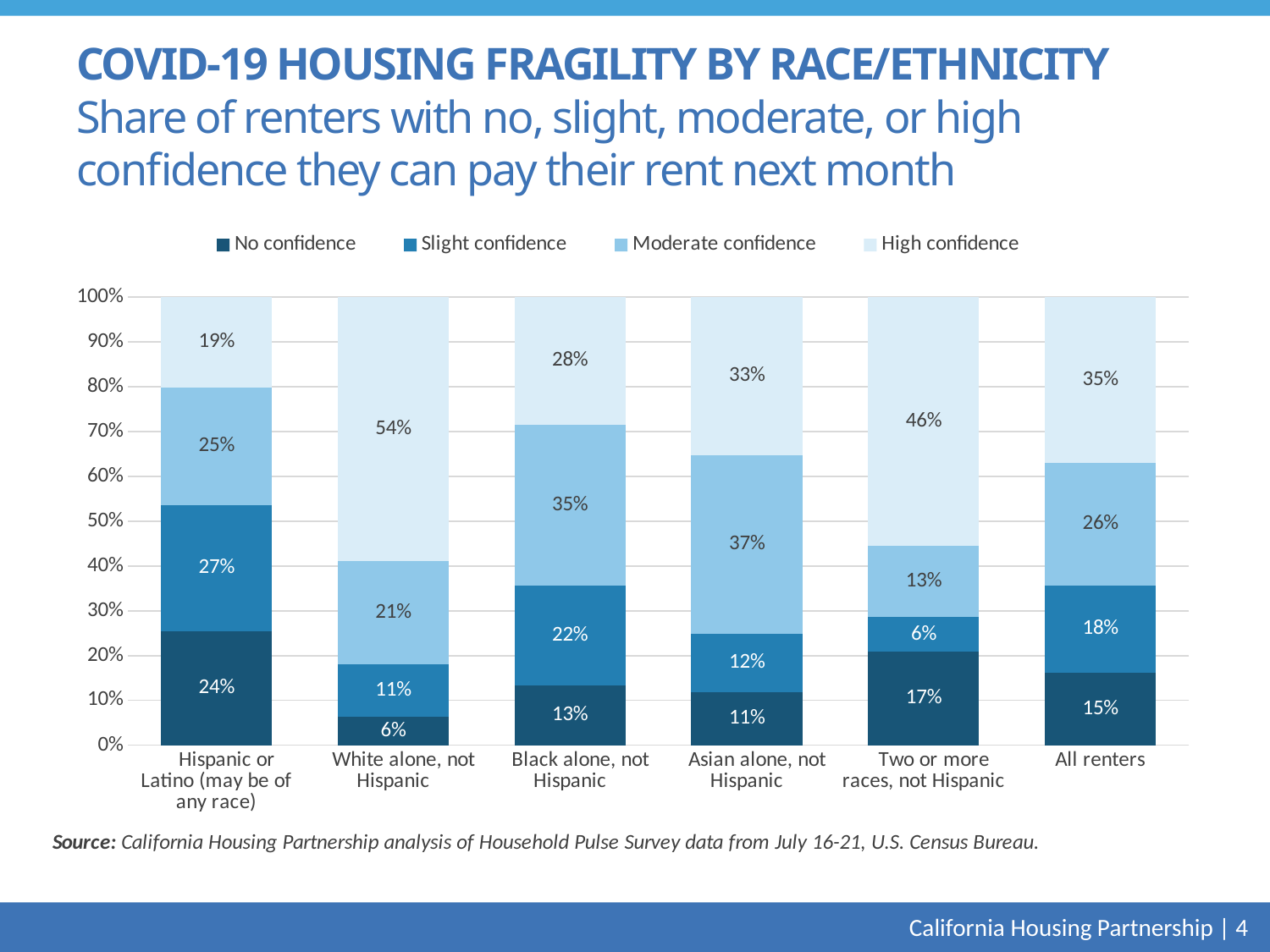
What is the slight confidence share for All renters? 18% Which group has the lowest share of renters with no confidence? White alone, not Hispanic How many series does the legend list? 4 What share of Hispanic or Latino renters reported no confidence they can pay their rent next month? 24% What share of White alone, not Hispanic renters reported high confidence? 54% What kind of chart is shown on the slide? Stacked bar chart What is the difference between the high confidence share for White alone, not Hispanic renters and for Hispanic or Latino renters? 35 percentage points How many race/ethnicity categories are shown on the x axis? 6 Which is larger: the no confidence share for Black alone, not Hispanic renters or for Two or more races, not Hispanic renters? Two or more races, not Hispanic Which group has the highest share of renters with no confidence? Hispanic or Latino (may be of any race) Which group has the highest share of renters with high confidence? White alone, not Hispanic What is the moderate confidence share for Asian alone, not Hispanic renters? 37%